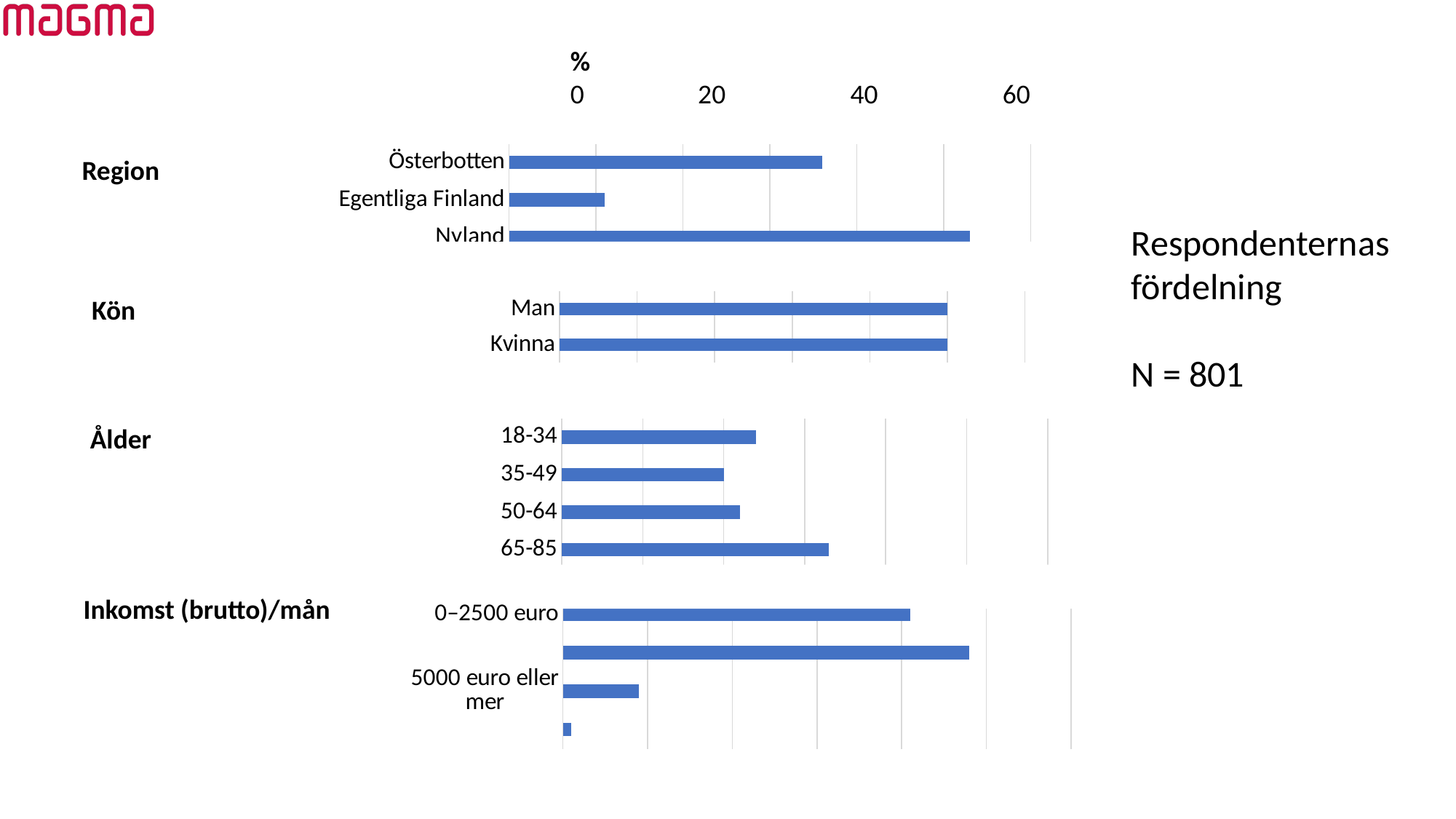
In the Region chart, is the value for Egentliga Finland greater or less than 20? less In the Ålder chart, which age group has the highest value? 65-85 How many categories does the Region chart show? 3 In the Region chart, which region has the lowest value? Egentliga Finland In the Region chart, which region has the highest value? Nyland How many categories does the Kön chart show? 2 In the Region chart, is the value for Nyland greater or less than 40? greater In the Region chart, which is larger, Österbotten or Egentliga Finland? Österbotten In the Kön chart, is the value for Man greater or less than 40? greater What kind of chart is the Region chart? bar chart